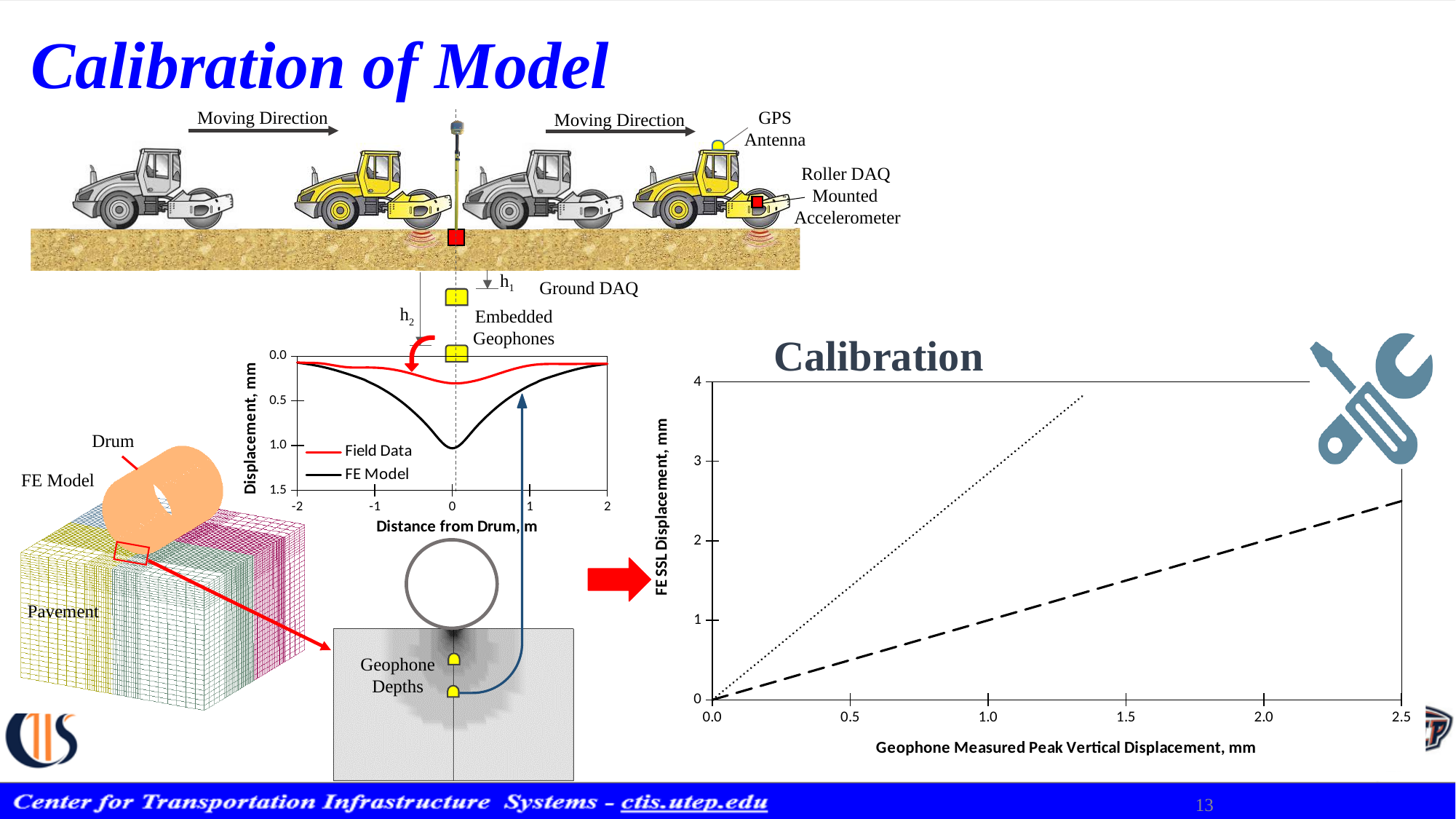
On the Displacement vs Distance from Drum chart, how many series does the legend list? 2 On the Displacement vs Distance from Drum chart, what is the label of the x axis? Distance from Drum, m On the Calibration chart, which line is steeper, the dotted line or the dashed line? the dotted line What kind of chart is the Calibration chart? line chart On the Displacement vs Distance from Drum chart, what are the two series named in the legend? Field Data and FE Model On the Calibration chart, do the plotted lines rise or fall as Geophone Measured Peak Vertical Displacement increases? rise On the Calibration chart, how many lines are plotted? 2 What kind of chart is the Displacement vs Distance from Drum chart? line chart On the Displacement vs Distance from Drum chart, is the FE Model displacement at 0 m greater or less than 0.5 mm? greater On the Calibration chart, is the dashed line's value at a geophone displacement of 2.5 mm greater or less than 2 mm? greater On the Displacement vs Distance from Drum chart, which series shows the larger displacement at a distance of 0 m, Field Data or FE Model? FE Model On the Displacement vs Distance from Drum chart, is the Field Data displacement at 0 m greater or less than 0.5 mm? less